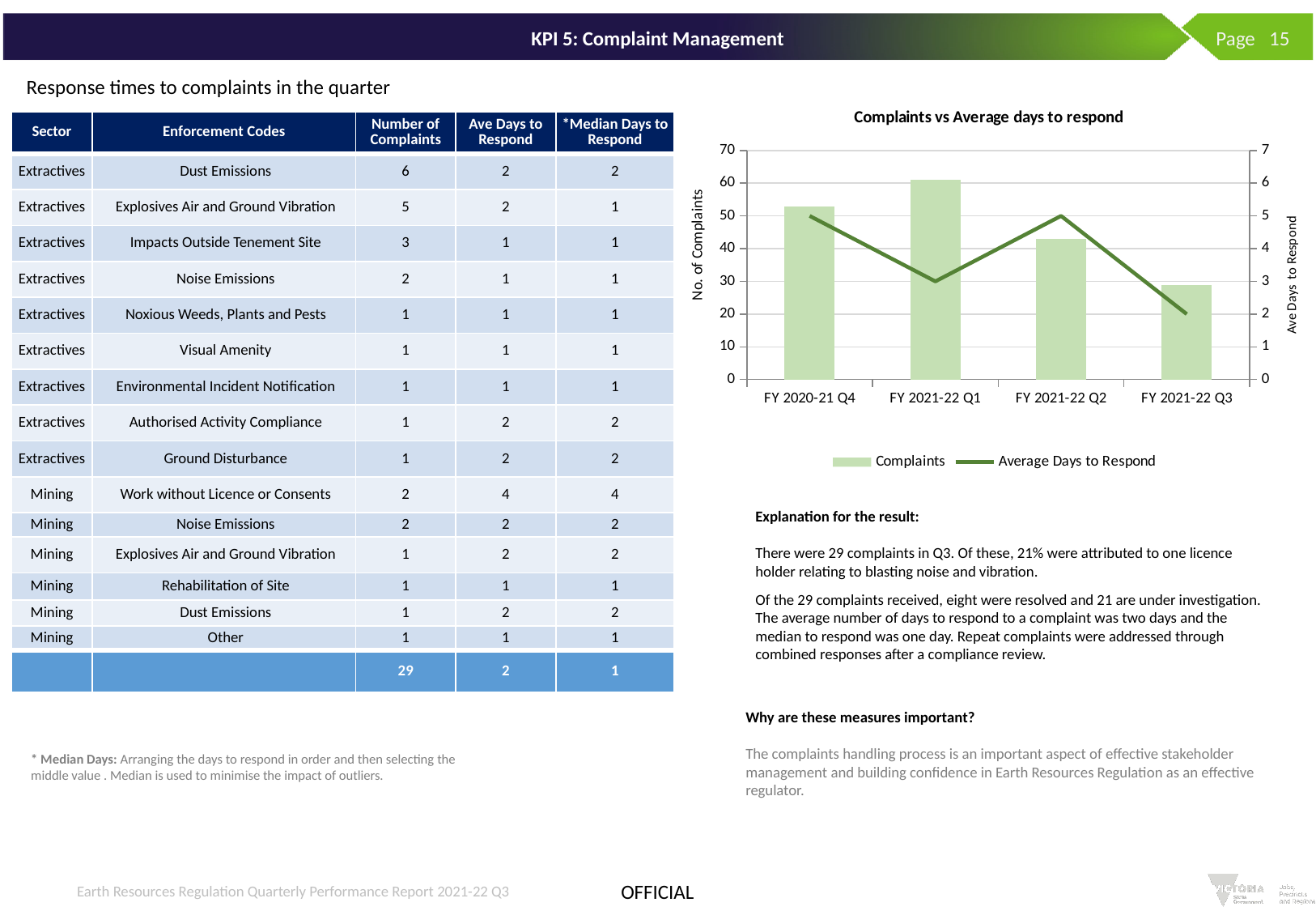
How many quarters are shown on the x axis of the 'Complaints vs Average days to respond' chart? 4 In the 'Complaints vs Average days to respond' chart, which quarter has the lowest number of complaints? FY 2021-22 Q3 In the 'Complaints vs Average days to respond' chart, which quarter has the highest number of complaints? FY 2021-22 Q1 In the 'Complaints vs Average days to respond' chart, is the number of complaints for FY 2021-22 Q1 greater or less than 50? greater How many series does the legend of the 'Complaints vs Average days to respond' chart list? 2 In the 'Complaints vs Average days to respond' chart, which has more complaints: FY 2020-21 Q4 or FY 2021-22 Q2? FY 2020-21 Q4 In the 'Complaints vs Average days to respond' chart, what is the Average Days to Respond for FY 2021-22 Q3? 2 In the 'Complaints vs Average days to respond' chart, which quarter has the lowest Average Days to Respond? FY 2021-22 Q3 What kind of chart is 'Complaints vs Average days to respond'? A bar chart with a line In the 'Complaints vs Average days to respond' chart, is the number of complaints for FY 2021-22 Q3 greater or less than 40? less In the 'Complaints vs Average days to respond' chart, what is the title of the right-hand vertical axis? Ave Days to Respond In the 'Complaints vs Average days to respond' chart, what is the Average Days to Respond for FY 2021-22 Q1? 3